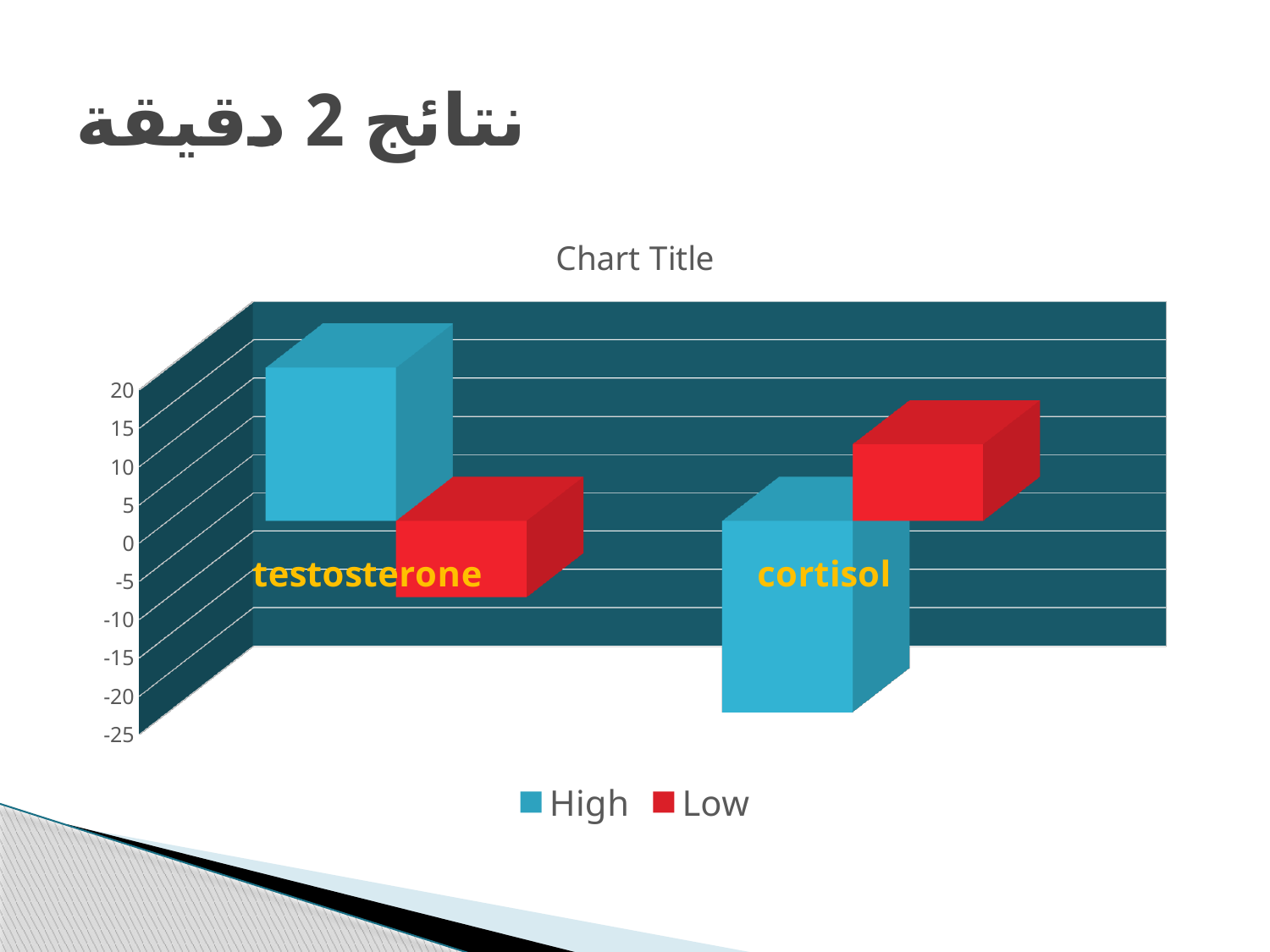
Which category has the higher High value, testosterone or cortisol? testosterone What kind of chart is shown on the slide? bar chart Is the High value for testosterone greater or less than 10? greater What are the names of the series listed in the chart's legend? High and Low Is the High value for cortisol greater or less than 0? less How many series does the chart's legend list? 2 Which bar in the chart has the lowest value? cortisol High Is the Low value for testosterone greater or less than 0? less How many categories are shown on the x axis of the chart? 2 Which category has the higher Low value, testosterone or cortisol? cortisol What is the title shown above the chart? Chart Title